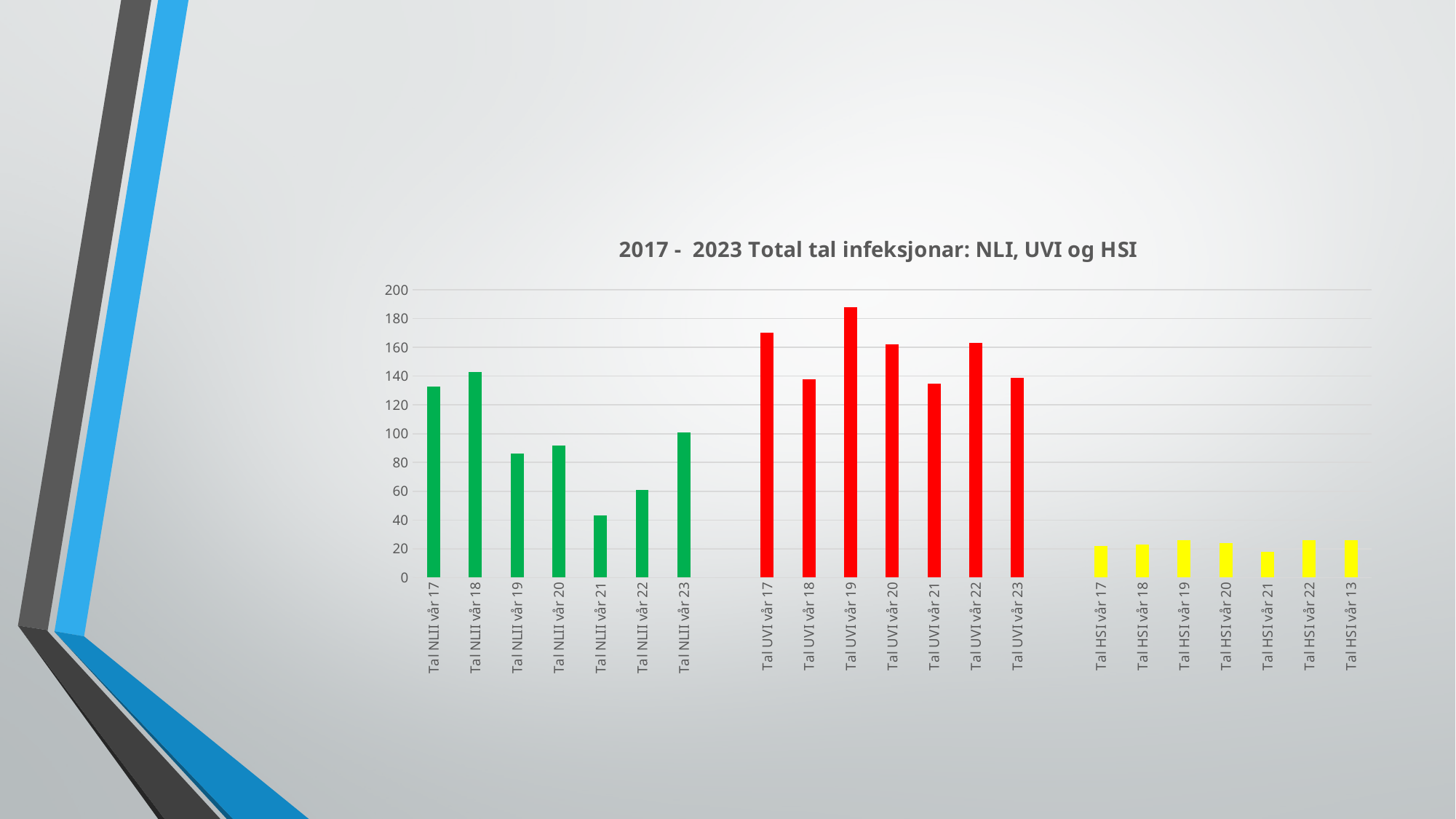
What is the title of the chart? 2017 - 2023 Total tal infeksjonar: NLI, UVI og HSI Which is larger, the value for Tal NLII vår 18 or Tal NLII vår 19? Tal NLII vår 18 Which is larger, the value for Tal UVI vår 22 or Tal UVI vår 21? Tal UVI vår 22 What kind of chart is shown on the slide? bar chart Which category has the highest value in the chart? Tal UVI vår 19 Is the value for Tal NLII vår 21 greater or less than 60? less Is the value for Tal UVI vår 17 greater or less than 160? greater Among the green NLII bars, which category has the lowest value? Tal NLII vår 21 Is the value for Tal NLII vår 17 greater or less than 120? greater How many bars are plotted in the chart? 21 What colour are the HSI bars in the chart? yellow